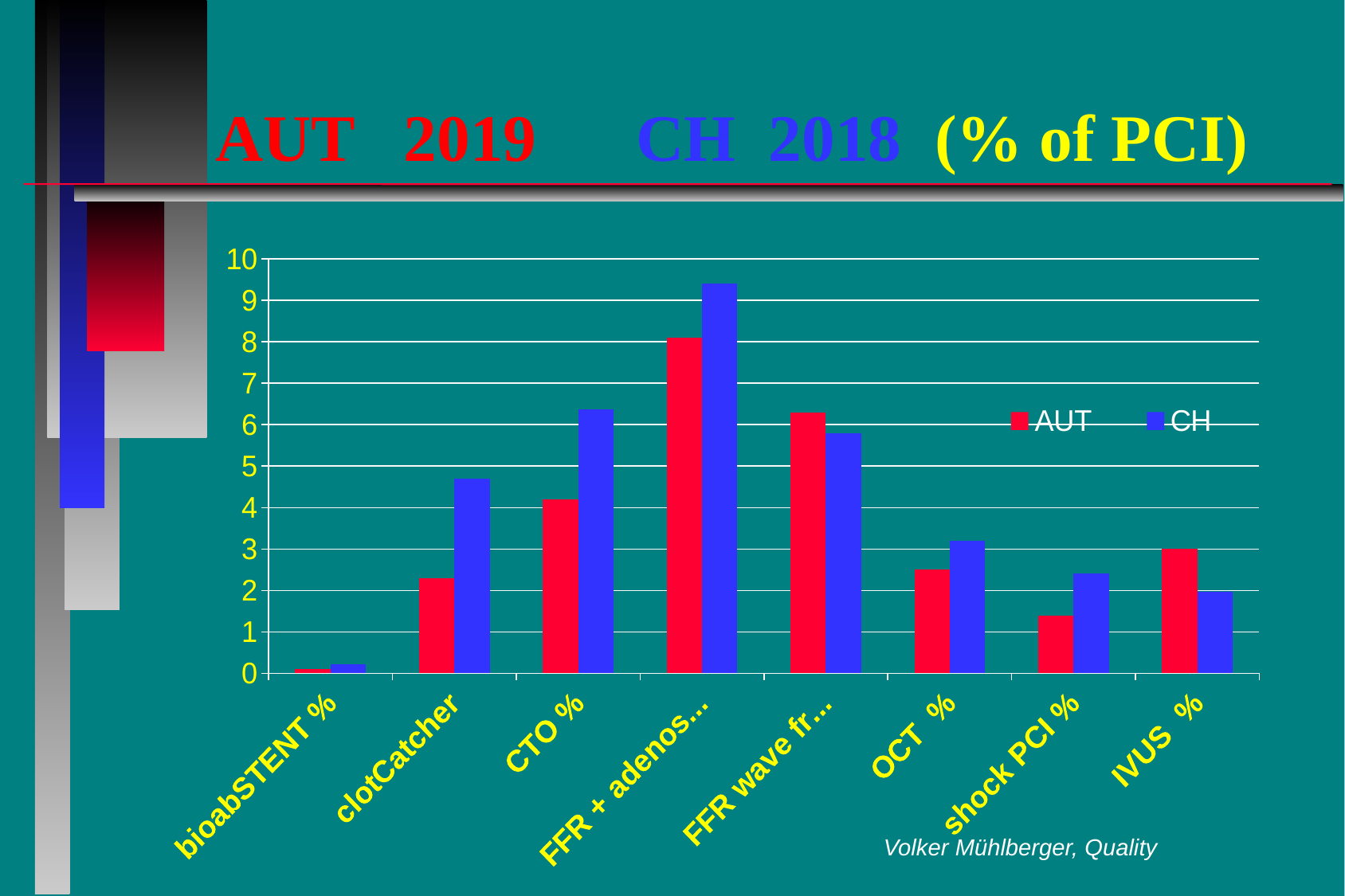
Which colour represents the CH series in the legend? blue Is the AUT value for clotCatcher greater or less than 3? less How many categories are shown on the x axis? 8 How many series does the legend list? 2 For CTO %, which series has the larger value, AUT or CH? CH Which category has the lowest value for the AUT series? bioabSTENT % For IVUS %, which series has the larger value, AUT or CH? AUT What kind of chart is shown on the slide? bar chart Which category has the highest value for the AUT series? FFR + adenos… Which category has the highest value for the CH series? FFR + adenos… Is the CH value for FFR + adenos… greater or less than 9? greater Which category has the lowest value for the CH series? bioabSTENT %